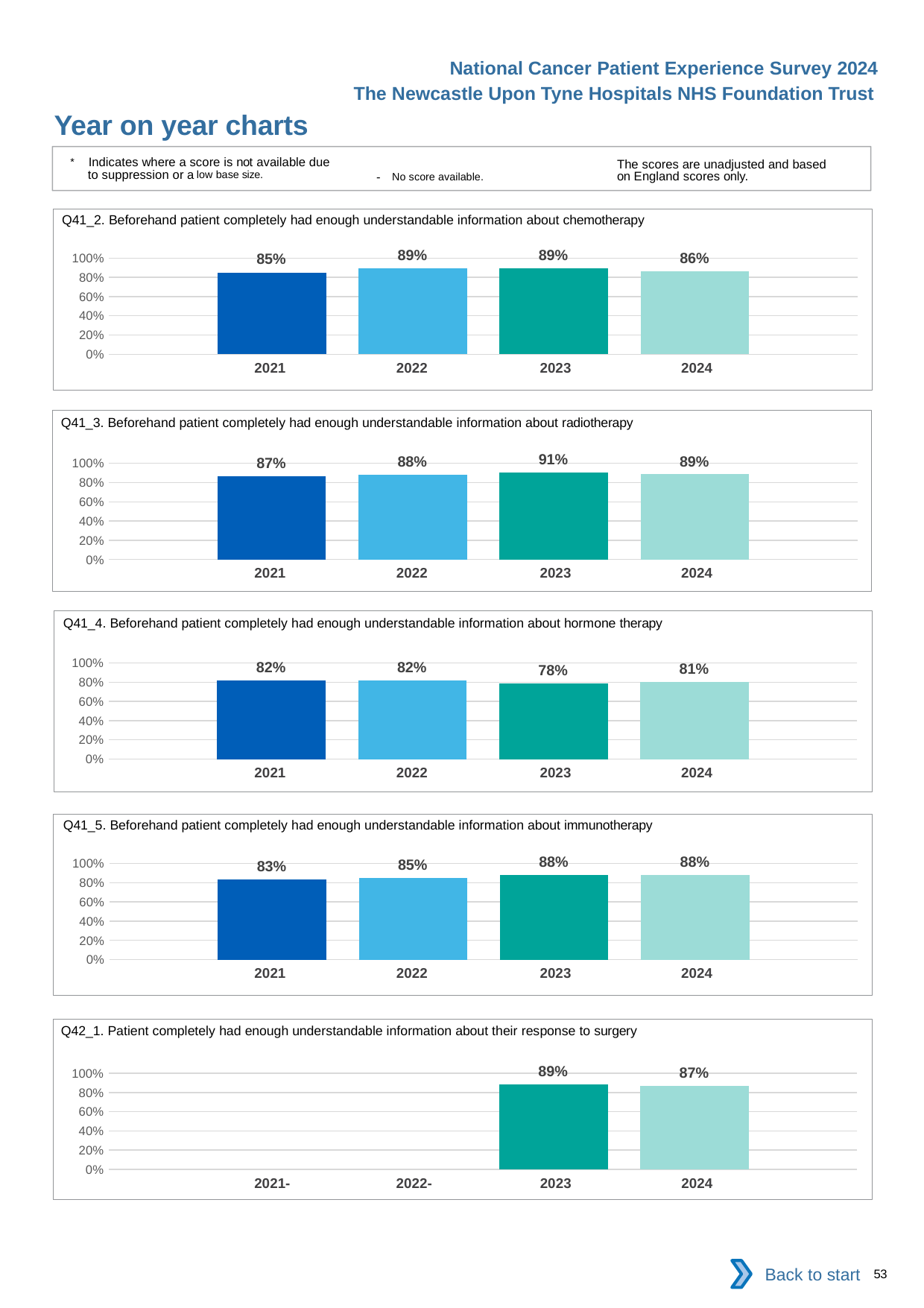
In the Q42_1 surgery chart, which is larger, the value for 2023 or 2024? 2023 In the Q41_5 immunotherapy chart, do the values rise or fall from 2021 to 2023? Rise What kind of chart is the Q41_3 radiotherapy chart? Bar chart In the Q41_2 chemotherapy chart, what is the value for 2021? 85% In the Q42_1 surgery chart, how many years have a bar plotted? 2 In the Q41_3 radiotherapy chart, what is the value for 2024? 89% In the Q41_3 radiotherapy chart, which year has the highest value? 2023 In the Q41_4 hormone therapy chart, is the value for 2023 greater or less than 60%? greater In the Q41_4 hormone therapy chart, which year has the lowest value? 2023 In the Q41_2 chemotherapy chart, what is the difference between the 2022 and 2024 values? 3% How many charts are shown on the slide? 5 In the Q41_5 immunotherapy chart, what is the difference between the 2023 and 2021 values? 5%